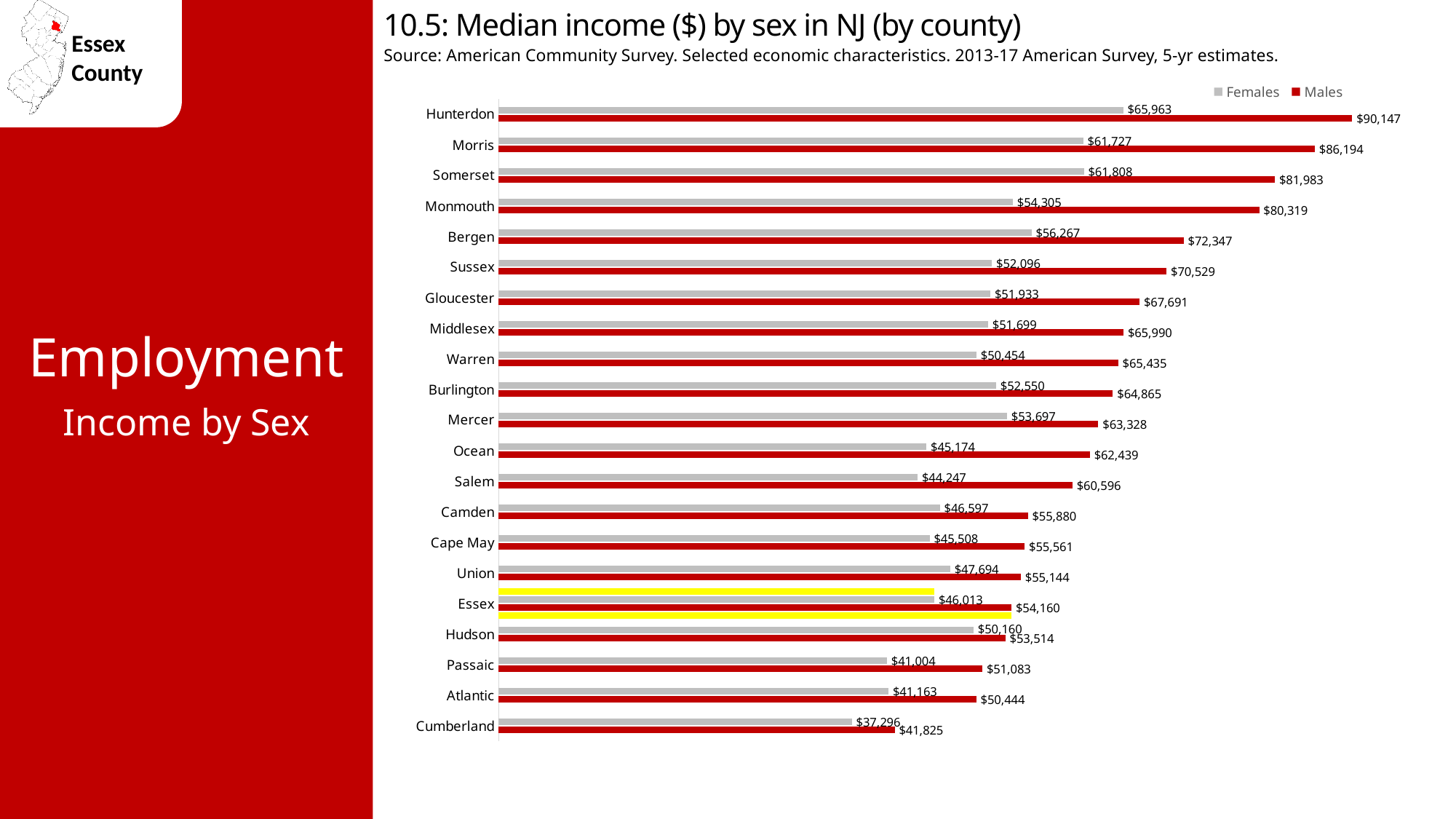
How many series does the legend list? 2 What is the median income for males in Essex County? $54,160 How many counties are shown in the chart? 21 What is the median income for females in Hunterdon County? $65,963 What is the difference between the male and female median incomes in Essex County? $8,147 Which county has the highest median income for males? Hunterdon What is the median income for females in Cumberland County? $37,296 Which colour represents the Males series in the chart? Red Which is larger: the female median income in Bergen or in Monmouth? Bergen What kind of chart is shown on the slide? Bar chart Which county has the lowest median income for females? Cumberland What is the difference between the male and female median incomes in Hunterdon County? $24,184